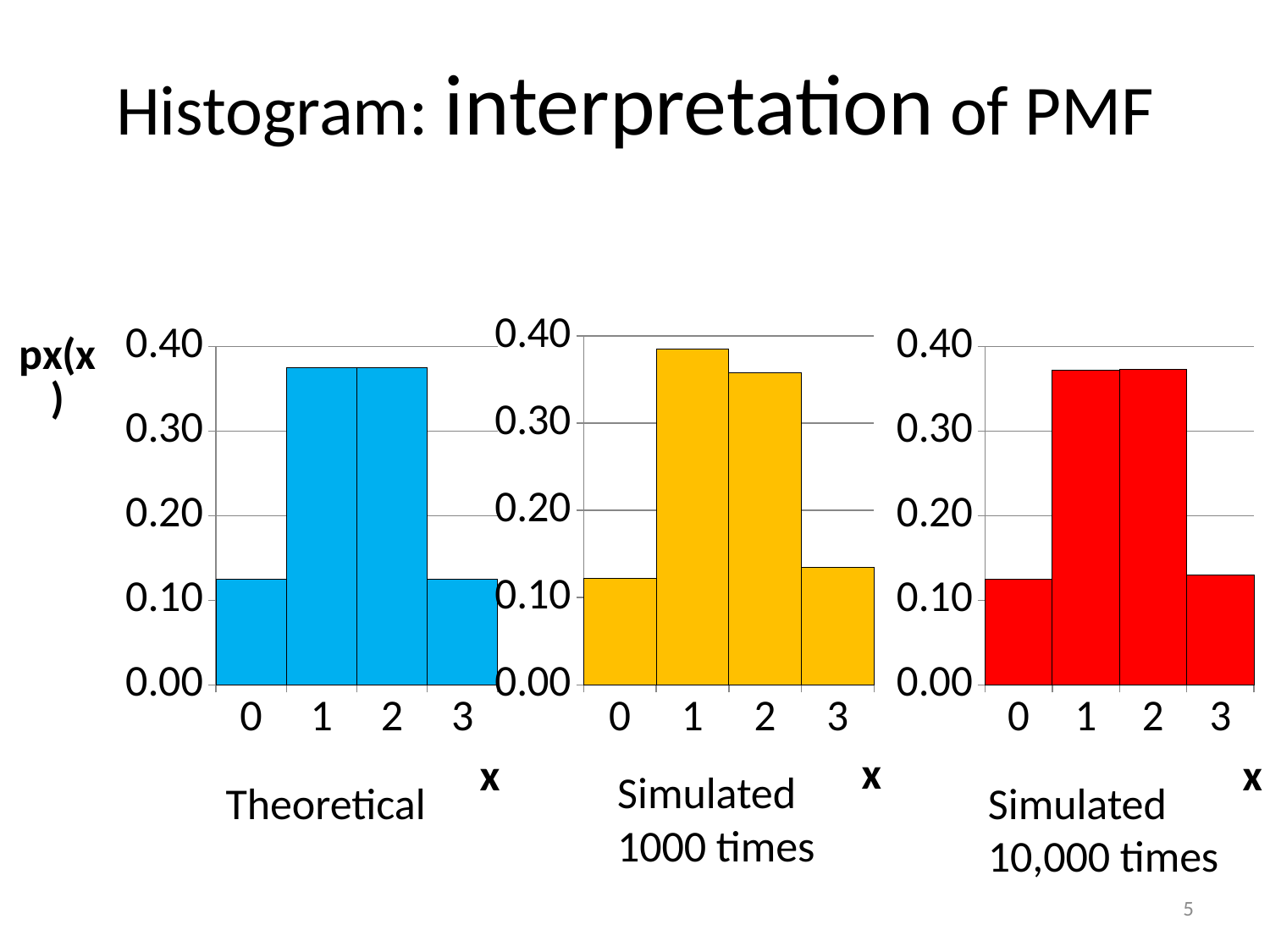
In the Simulated 10,000 times chart, is the value for x = 0 greater or less than 0.20? less In the Simulated 10,000 times chart, is the value for x = 2 greater or less than 0.40? less In the Theoretical chart, is the value for x = 0 greater or less than 0.10? greater In the Theoretical chart, how many bars are plotted? 4 What colour are the bars in the Theoretical chart? blue In the Simulated 10,000 times chart, which is larger, the value for x = 1 or x = 3? x = 1 In the Simulated 1000 times chart, which x value has the highest bar? 1 What kind of chart is the Simulated 1000 times chart? bar chart In the Simulated 1000 times chart, which is larger, the value for x = 1 or x = 2? x = 1